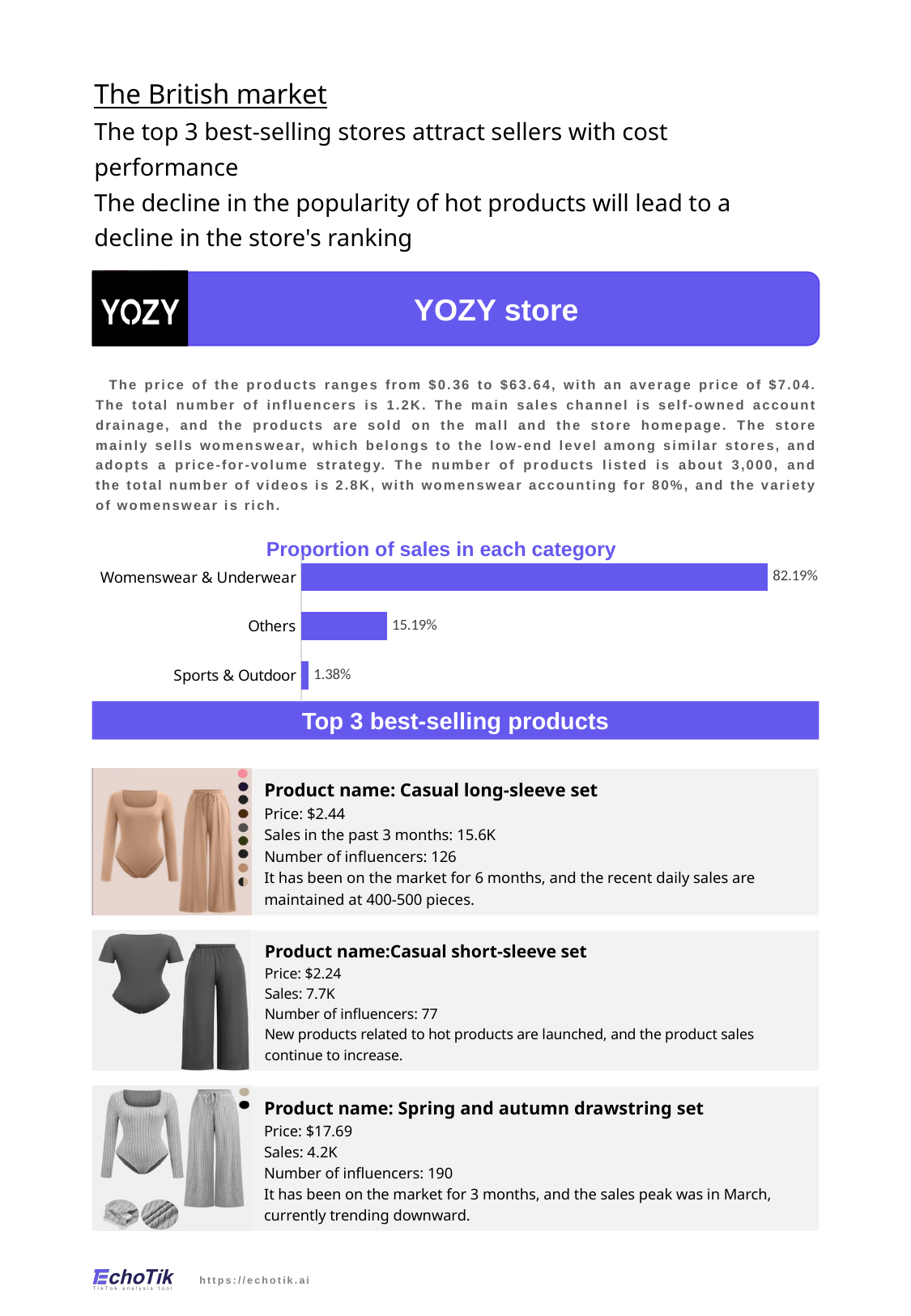
How many categories are shown in the 'Proportion of sales in each category' chart? 3 Which category has the highest proportion of sales in the chart? Womenswear & Underwear What is the difference between the Womenswear & Underwear and Others values in the chart? 67.00% What kind of chart is used to show the proportion of sales in each category? Bar chart Which category has the lowest proportion of sales in the chart? Sports & Outdoor What colour are the bars in the 'Proportion of sales in each category' chart? Purple What is the difference between the Others and Sports & Outdoor values in the chart? 13.81% What is the value for Others in the 'Proportion of sales in each category' chart? 15.19% What is the value for Sports & Outdoor in the 'Proportion of sales in each category' chart? 1.38% What is the value for Womenswear & Underwear in the 'Proportion of sales in each category' chart? 82.19% Which is larger in the chart, the value for Others or the value for Sports & Outdoor? Others What is the title of the chart on the slide? Proportion of sales in each category